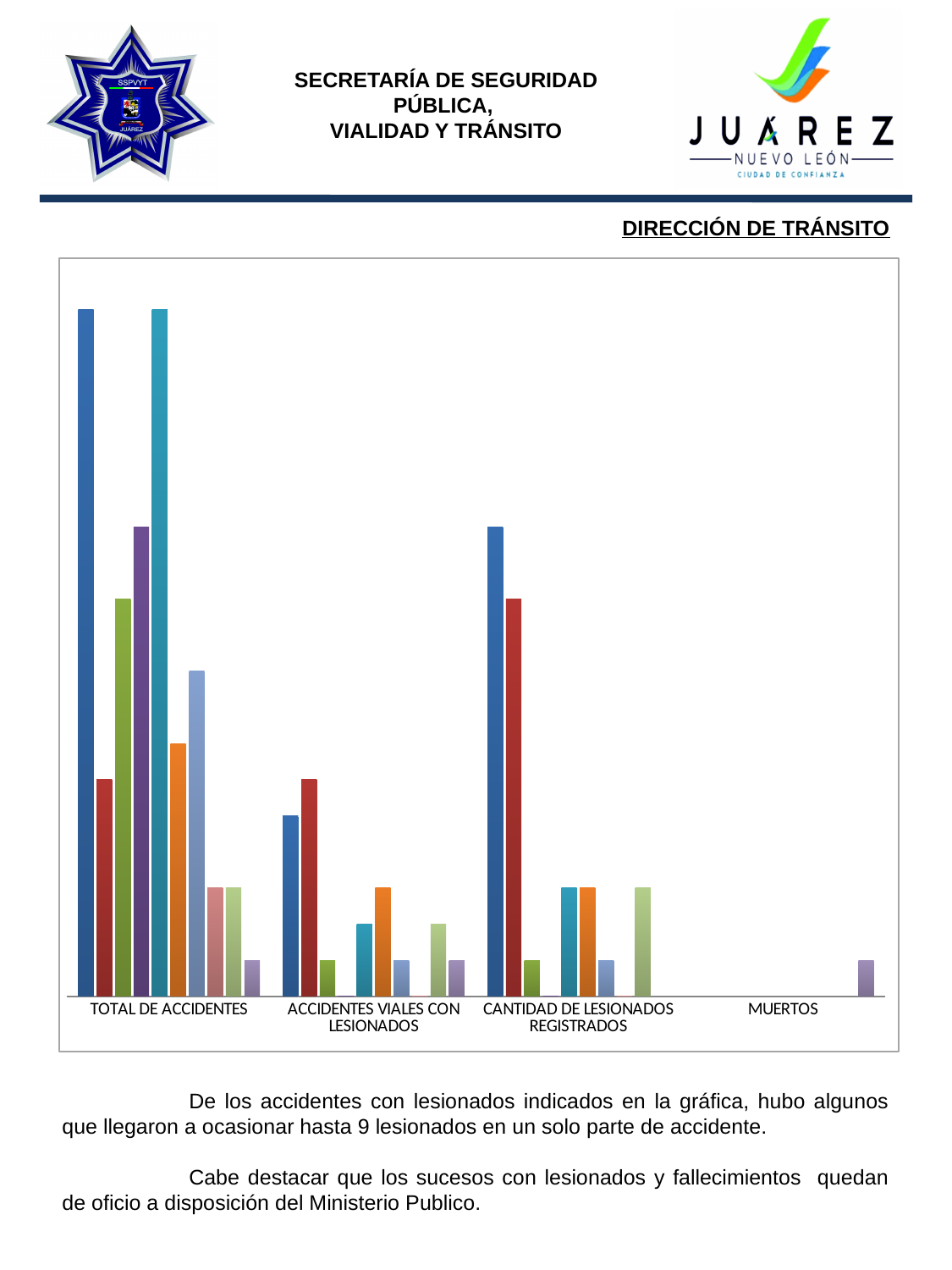
What is the label of the last category on the x axis of the chart? MUERTOS Does the chart display a legend identifying the series? No In the TOTAL DE ACCIDENTES group, is the first (dark blue) bar taller or shorter than the second (red) bar? taller Which category on the x axis has the smallest bars overall? MUERTOS Which category has a taller tallest bar: ACCIDENTES VIALES CON LESIONADOS or CANTIDAD DE LESIONADOS REGISTRADOS? CANTIDAD DE LESIONADOS REGISTRADOS In the CANTIDAD DE LESIONADOS REGISTRADOS group, is the dark blue bar taller or shorter than the red bar? taller Which category on the x axis contains the tallest bars in the chart? TOTAL DE ACCIDENTES What kind of chart is shown on the slide? bar chart How many categories are shown along the x axis of the chart? 4